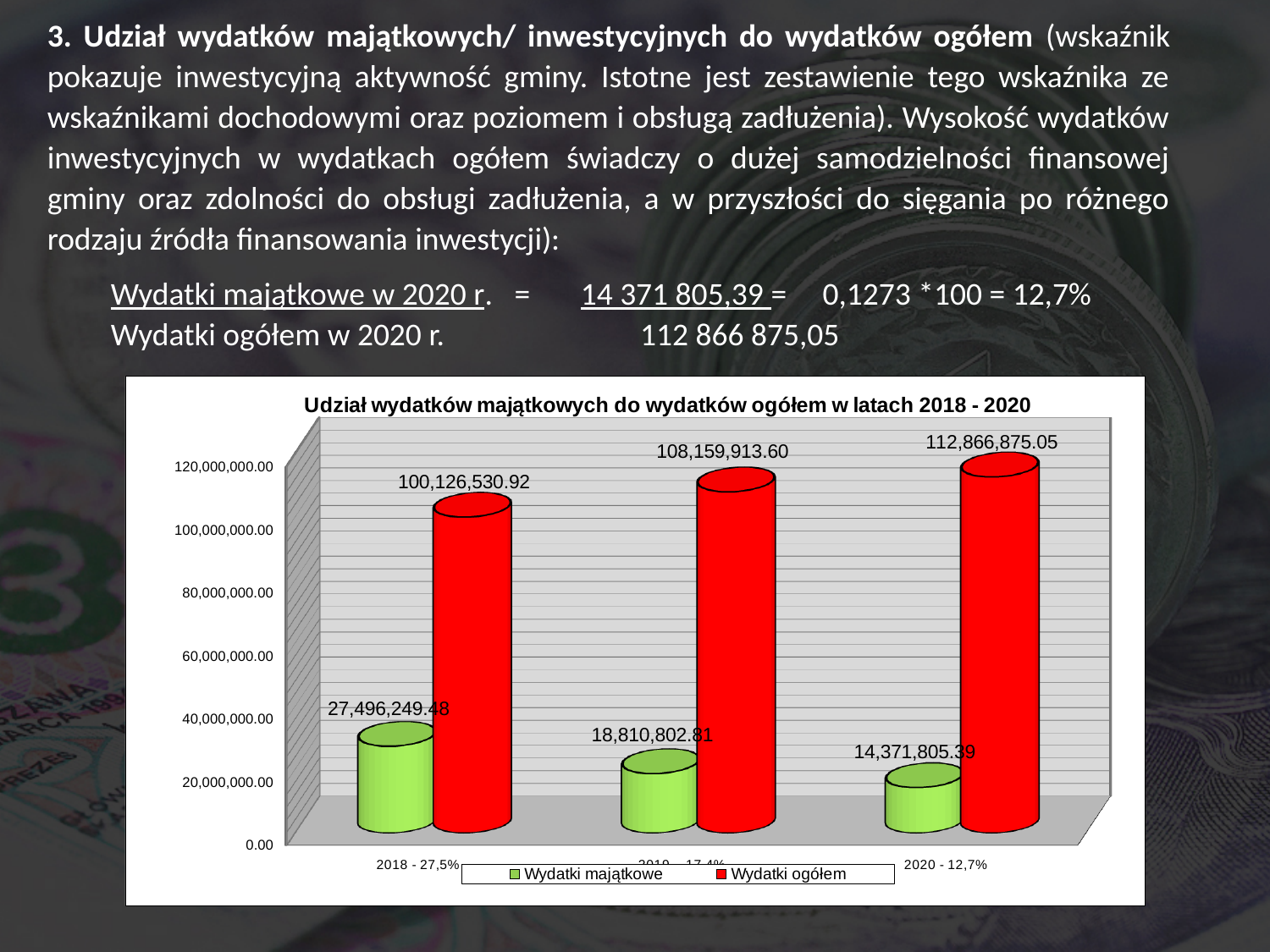
What is the value of Wydatki ogółem for 2018 - 27,5%? 100,126,530.92 What is the difference between Wydatki ogółem and Wydatki majątkowe for 2020 - 12,7%? 98,495,069.66 What type of chart is shown on the slide? bar chart How many series does the chart legend list? 2 Which colour represents Wydatki ogółem in the chart? red What is the value of Wydatki ogółem for 2020 - 12,7%? 112,866,875.05 Which category has the highest value of Wydatki ogółem? 2020 - 12,7% What is the value of Wydatki majątkowe for 2018 - 27,5%? 27,496,249.48 Does the value of Wydatki majątkowe rise or fall from 2018 to 2020? fall Which category has the lowest value of Wydatki majątkowe? 2020 - 12,7% What is the title of the chart? Udział wydatków majątkowych do wydatków ogółem w latach 2018 - 2020 What is the value of Wydatki majątkowe for 2020 - 12,7%? 14,371,805.39